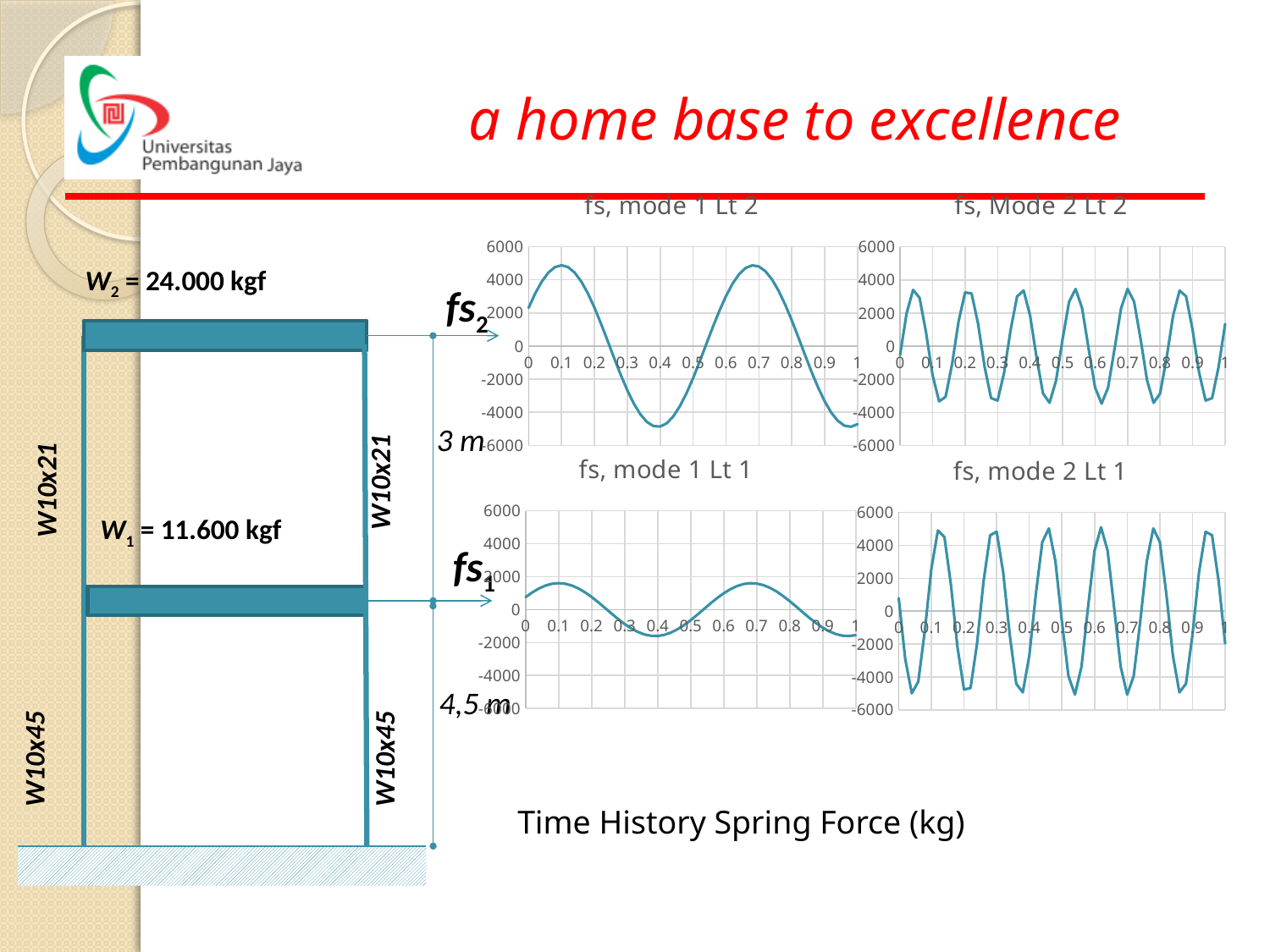
In the chart "fs, mode 1 Lt 2", is the peak value near x = 0.1 greater or less than 4000? greater What kind of chart is "fs, mode 1 Lt 2"? line chart Which chart reaches a higher peak value: "fs, mode 1 Lt 2" or "fs, mode 1 Lt 1"? fs, mode 1 Lt 2 In the chart "fs, mode 1 Lt 1", is the peak value near x = 0.1 greater or less than 2000? less In the chart "fs, mode 1 Lt 1", does the line rise or fall between x = 0 and x = 0.1? rise What is the highest value shown on the y axis of the chart "fs, mode 2 Lt 1"? 6000 In the chart "fs, Mode 2 Lt 2", is the highest peak greater or less than 4000? less In the chart "fs, mode 1 Lt 2", does the line rise or fall between x = 0.1 and x = 0.4? fall How many charts are shown on the slide? 4 Which chart has more oscillation cycles between x = 0 and x = 1: "fs, mode 1 Lt 2" or "fs, Mode 2 Lt 2"? fs, Mode 2 Lt 2